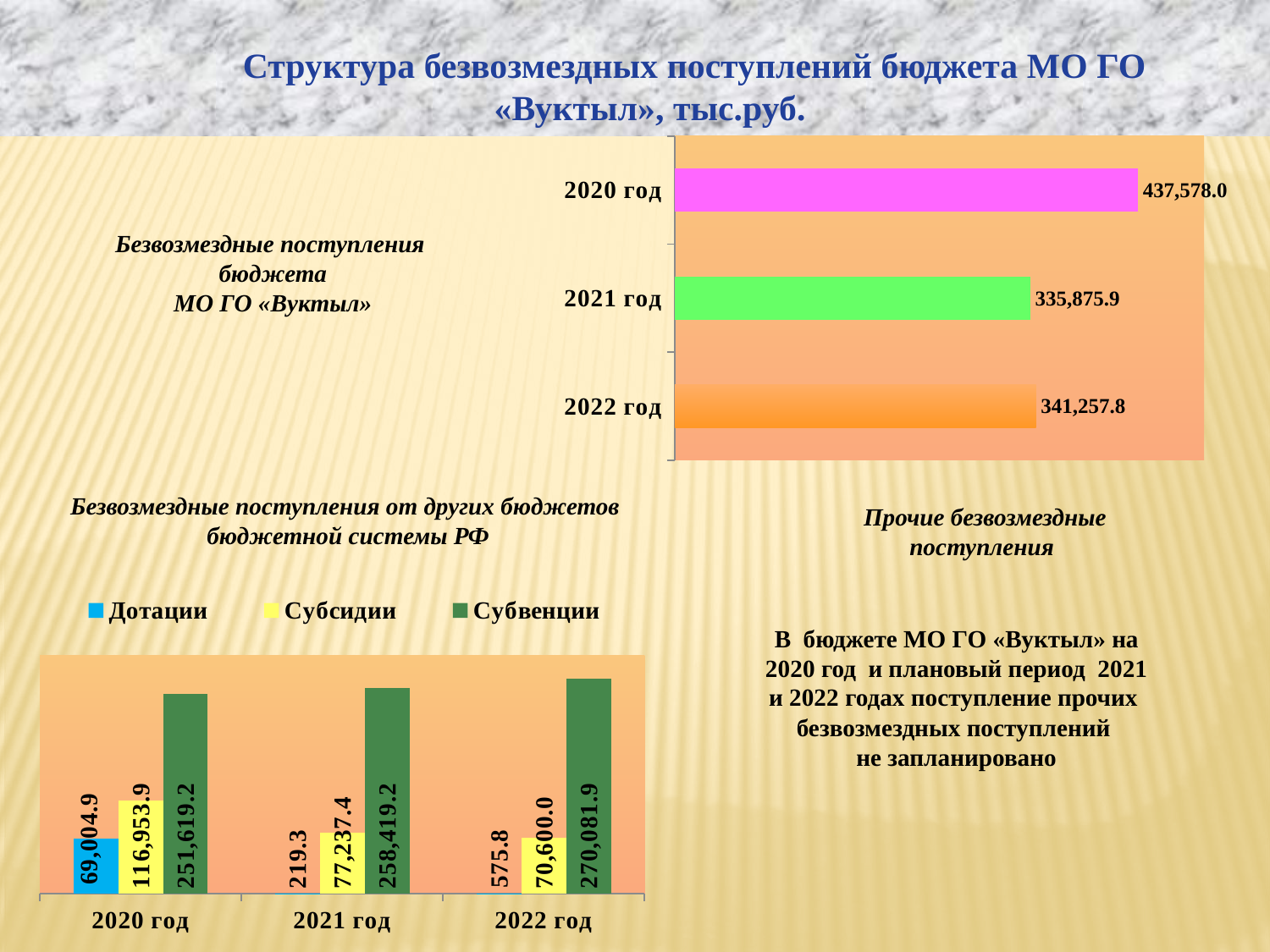
What kind of chart is the top-right chart (Безвозмездные поступления бюджета МО ГО «Вуктыл»)? Bar chart In the bottom-left chart (Безвозмездные поступления от других бюджетов бюджетной системы РФ), what is the difference between Субвенции for 2022 год and Субвенции for 2020 год? 18,462.7 In the top-right chart (Безвозмездные поступления бюджета МО ГО «Вуктыл»), which year has the lowest value? 2021 год In the top-right chart (Безвозмездные поступления бюджета МО ГО «Вуктыл»), what is the value for 2020 год? 437,578.0 In the top-right chart (Безвозмездные поступления бюджета МО ГО «Вуктыл»), which year has the highest value? 2020 год In the bottom-left chart (Безвозмездные поступления от других бюджетов бюджетной системы РФ), do the Субвенции values rise or fall from 2020 год to 2022 год? Rise In the top-right chart (Безвозмездные поступления бюджета МО ГО «Вуктыл»), how many years are shown? 3 In the bottom-left chart (Безвозмездные поступления от других бюджетов бюджетной системы РФ), what is the value of Субсидии for 2021 год? 77,237.4 In the top-right chart (Безвозмездные поступления бюджета МО ГО «Вуктыл»), what is the value for 2022 год? 341,257.8 In the top-right chart (Безвозмездные поступления бюджета МО ГО «Вуктыл»), what is the difference between the 2020 год and 2021 год values? 101,702.1 In the bottom-left chart (Безвозмездные поступления от других бюджетов бюджетной системы РФ), what is the value of Дотации for 2022 год? 575.8 In the bottom-left chart (Безвозмездные поступления от других бюджетов бюджетной системы РФ), how many series does the legend list? 3